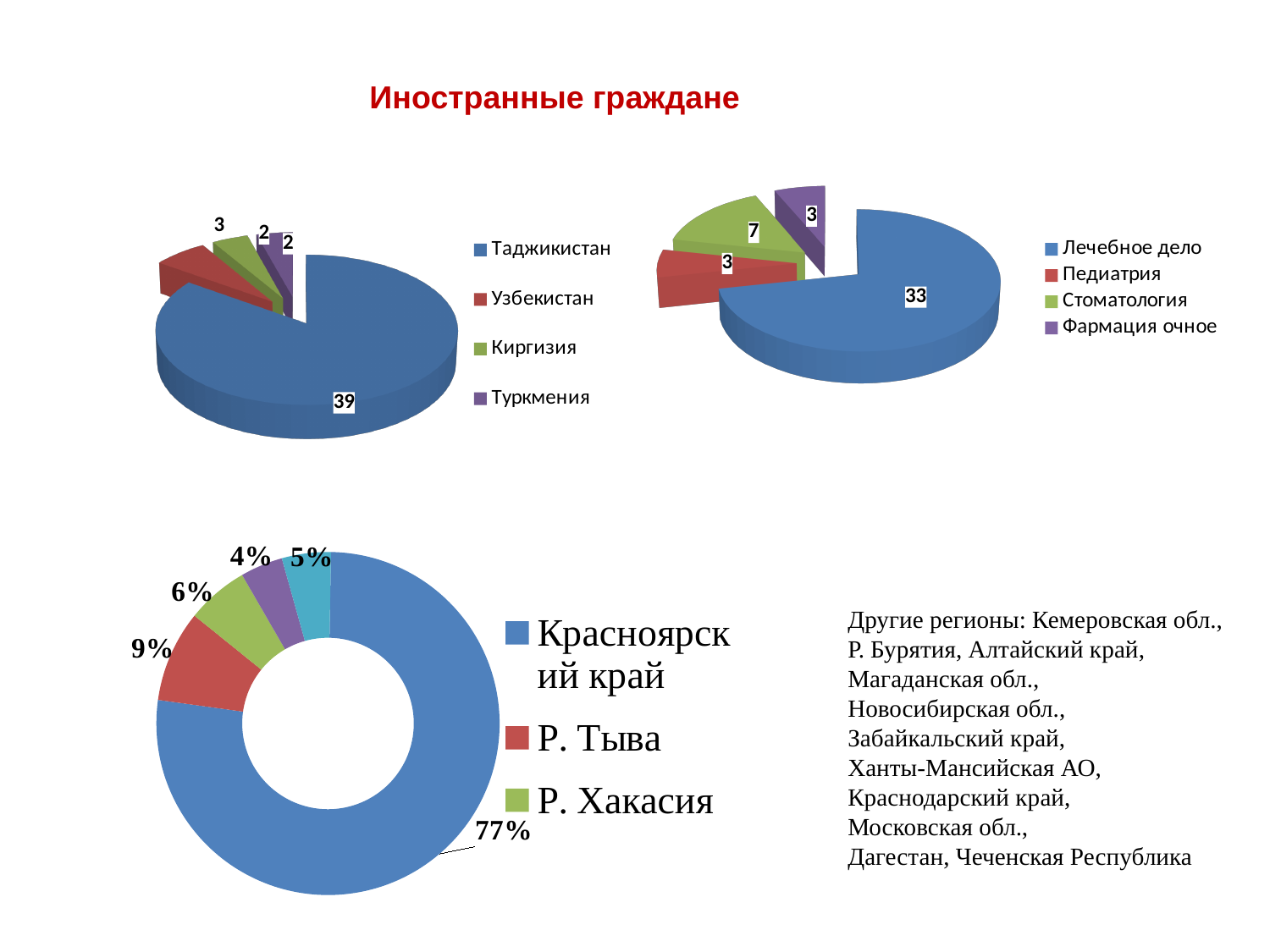
In the bottom-left doughnut chart, what share does Р. Тыва have? 9% In the top-right pie chart, which is larger, Стоматология or Педиатрия? Стоматология In the top-left pie chart, what is the value for Таджикистан? 39 In the top-left pie chart, which category has the largest value? Таджикистан In the top-right pie chart, what is the value for Стоматология? 7 In the top-right pie chart, what is the value for Лечебное дело? 33 In the top-right pie chart, what is the total of all the slice values? 46 In the top-left pie chart, what is the value for Узбекистан? 3 In the top-left pie chart, how many categories does the legend list? 4 What kind of chart is the bottom-left chart? Doughnut chart In the top-left pie chart, what is the difference between the values for Таджикистан and Узбекистан? 36 In the bottom-left doughnut chart, what share does Красноярский край have? 77%